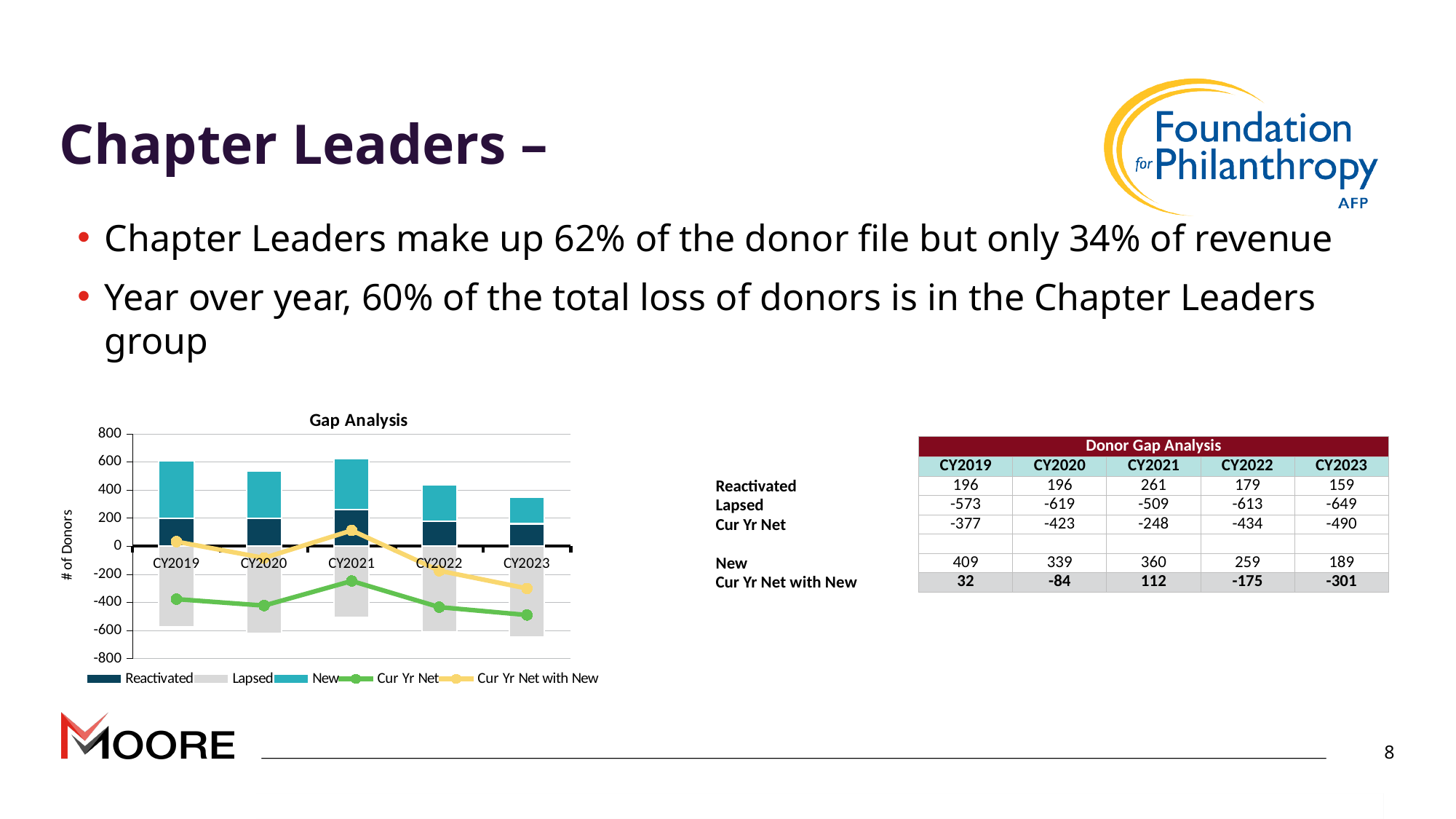
What is the Lapsed value for CY2020? -619 In which year is Cur Yr Net lowest? CY2023 In which year is Cur Yr Net with New highest? CY2021 How many series does the legend of the Gap Analysis chart list? 5 What is the Cur Yr Net with New value for CY2023? -301 Is the Cur Yr Net value for CY2019 greater or less than -200? less How many years are shown on the x axis of the Gap Analysis chart? 5 What is the label on the vertical axis of the Gap Analysis chart? # of Donors What is the difference between the New value for CY2019 and the New value for CY2023? 220 What kind of chart is the Gap Analysis chart? A combined bar and line chart Does the Cur Yr Net with New line rise or fall from CY2021 to CY2023? Fall Which year has the larger Reactivated value, CY2021 or CY2022? CY2021